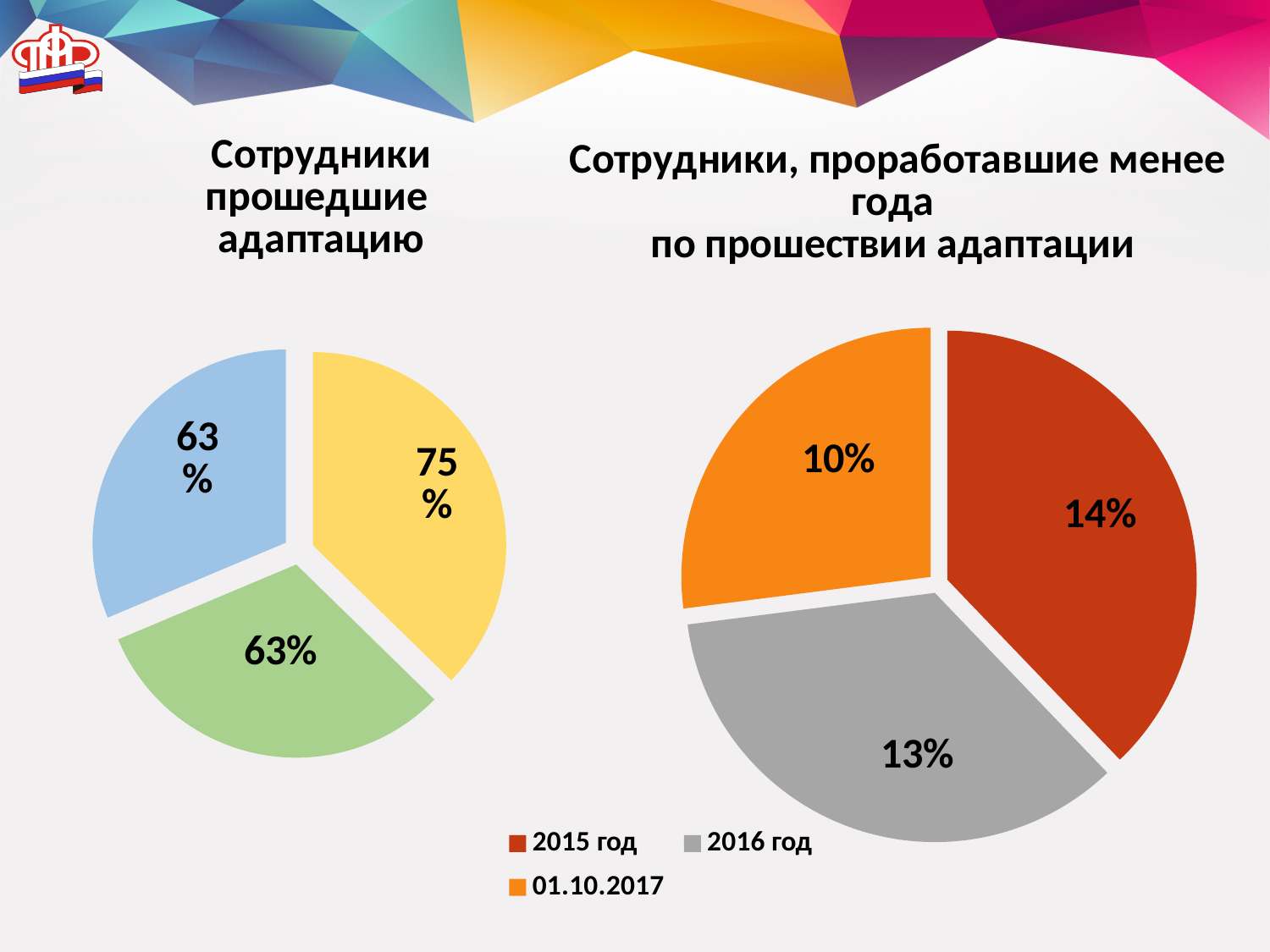
In the chart titled "Сотрудники, проработавшие менее года по прошествии адаптации", which category has the highest value? 2015 год What kind of chart is the chart titled "Сотрудники, проработавшие менее года по прошествии адаптации"? pie chart In the chart titled "Сотрудники прошедшие адаптацию", what is the value shown on the yellow slice? 75% In the chart titled "Сотрудники, проработавшие менее года по прошествии адаптации", what is the value for 01.10.2017? 10% In the chart titled "Сотрудники, проработавшие менее года по прошествии адаптации", what is the value for 2016 год? 13% In the chart titled "Сотрудники, проработавшие менее года по прошествии адаптации", what is the difference between the values for 2015 год and 01.10.2017? 4% In the chart titled "Сотрудники, проработавшие менее года по прошествии адаптации", what is the value for 2015 год? 14% In the chart titled "Сотрудники, проработавшие менее года по прошествии адаптации", which category has the lowest value? 01.10.2017 How many entries does the legend of the chart titled "Сотрудники, проработавшие менее года по прошествии адаптации" list? 3 In the chart titled "Сотрудники, проработавшие менее года по прошествии адаптации", which is larger: the value for 2016 год or the value for 01.10.2017? 2016 год In the chart titled "Сотрудники, проработавшие менее года по прошествии адаптации", what colour is the slice for 2016 год? grey How many slices does the chart titled "Сотрудники прошедшие адаптацию" have? 3